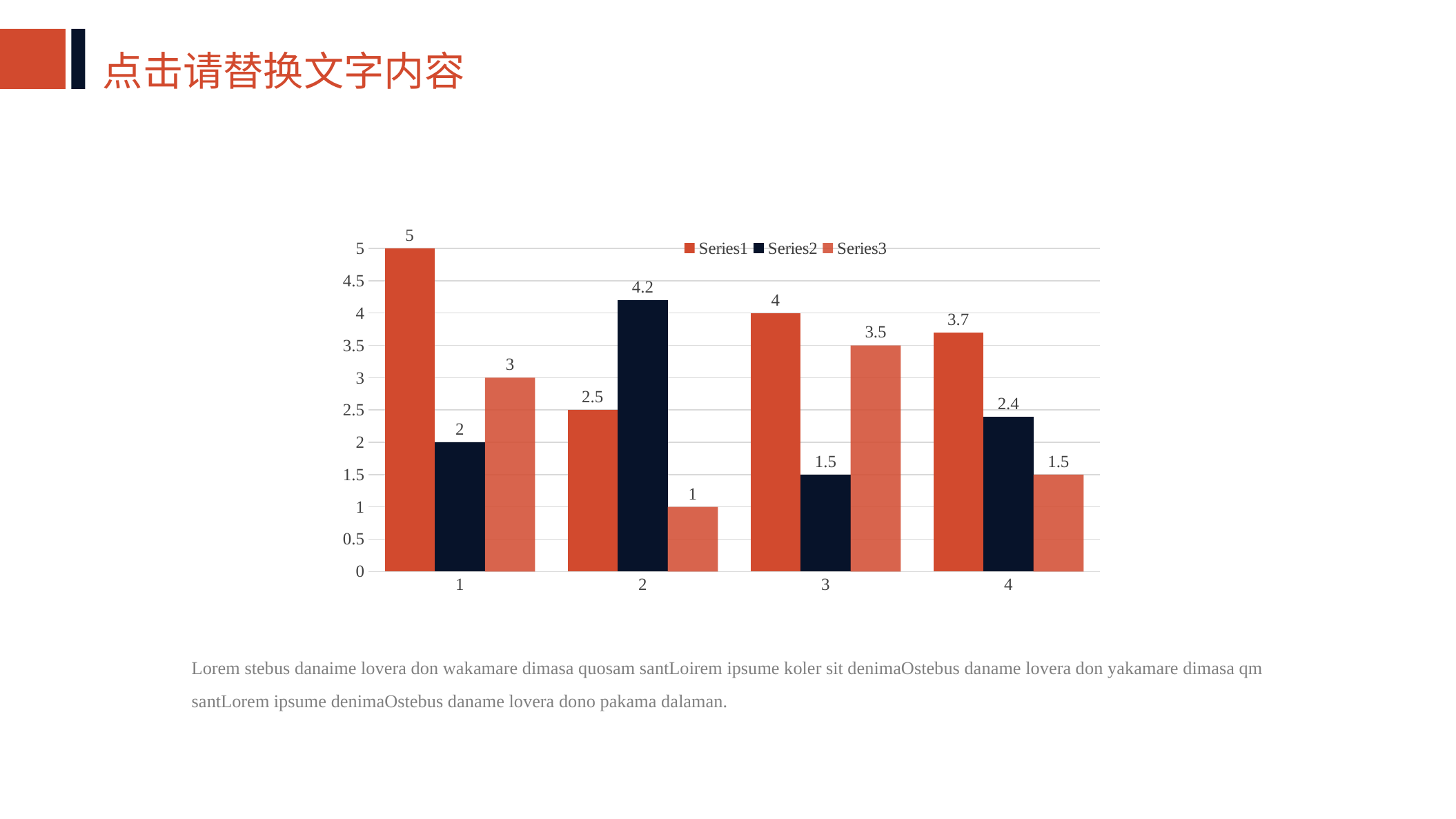
What is the value of Series3 for category 3? 3.5 Which category has the highest value for Series1? 1 What is the value of Series2 for category 2? 4.2 Which is larger for category 2: Series1 or Series2? Series2 How many categories are shown on the x axis? 4 How many series does the legend list? 3 What is the value of Series1 for category 1? 5 What is the difference between Series1 and Series2 for category 1? 3 Which category has the lowest value for Series3? 2 What kind of chart is shown on the slide? Bar chart What is the value of Series1 for category 4? 3.7 What is the total of Series1, Series2 and Series3 for category 4? 7.6